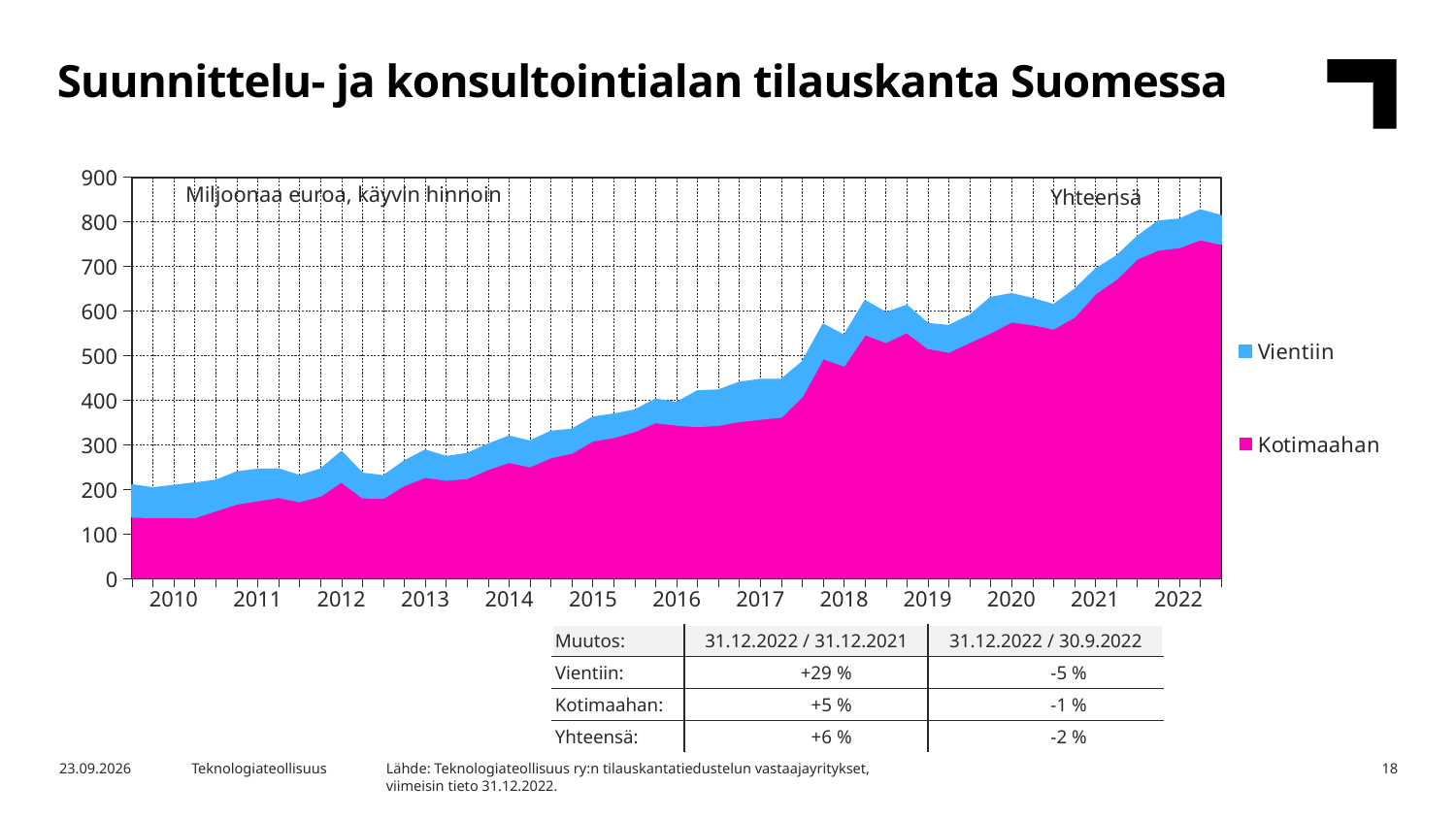
In which year does the total order backlog reach its highest level? 2022 Is the total order backlog in 2015 greater or less than 500? less Which series is larger throughout the chart, Vientiin or Kotimaahan? Kotimaahan Is the total order backlog at the end of 2022 greater or less than 700? greater What kind of chart is shown on the slide? Stacked area chart Does the total order backlog (Yhteensä) rise or fall overall from 2010 to 2022? Rise How many years are labelled on the x axis of the chart? 13 What unit label is shown inside the chart area? Miljoonaa euroa, käyvin hinnoin How many series does the chart legend list? 2 Is the Kotimaahan value at the start of 2010 greater or less than 200? less Which two series are listed in the chart legend? Vientiin and Kotimaahan In which year is the total order backlog at its lowest level? 2010